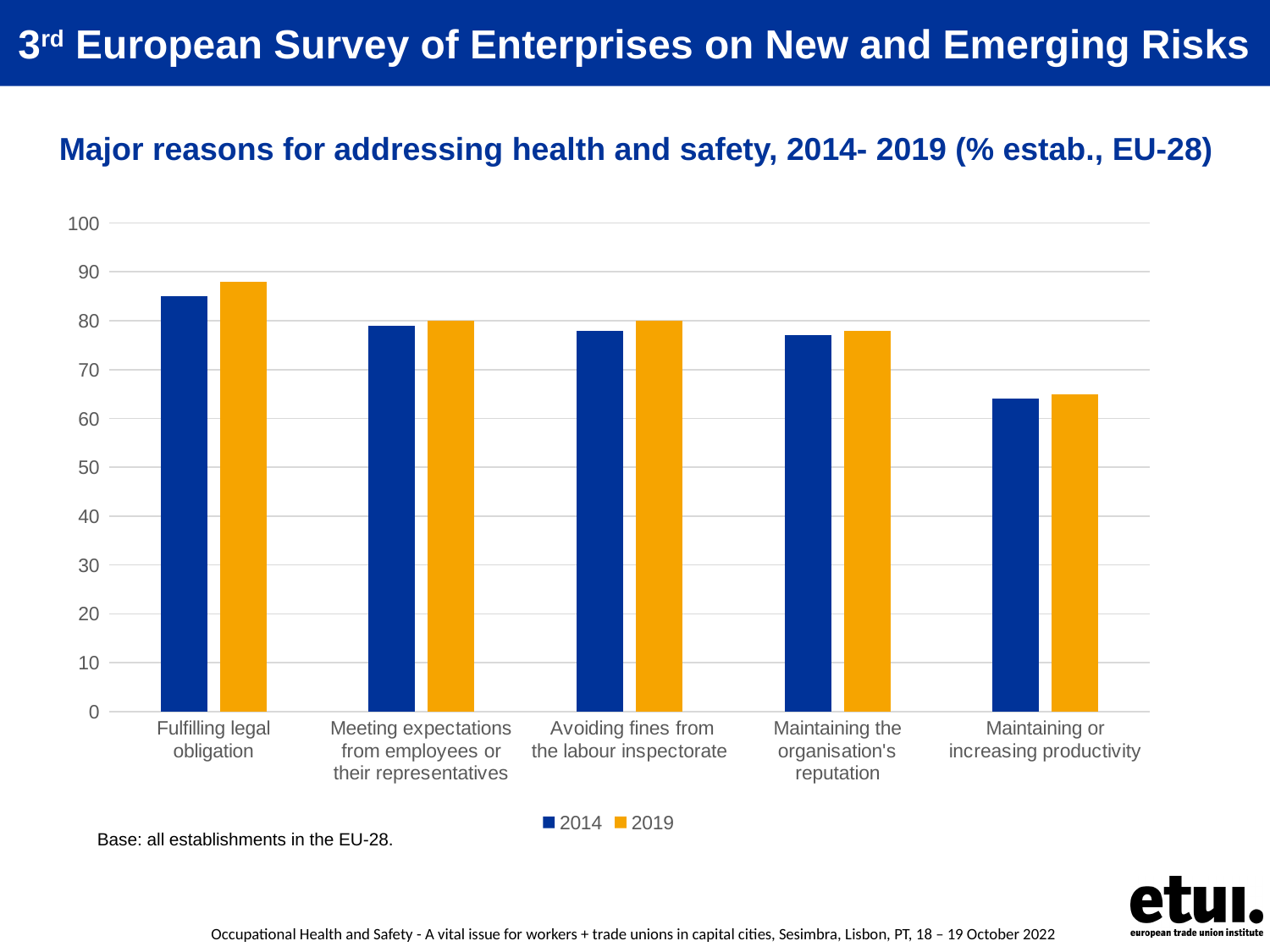
Which category has the highest value for 2019? Fulfilling legal obligation What is the title of the chart? Major reasons for addressing health and safety, 2014- 2019 (% estab., EU-28) Is the 2014 value for Maintaining or increasing productivity greater or less than 70? less Which colour represents the 2019 series in the chart? orange Is the 2019 value for Maintaining or increasing productivity greater or less than 60? greater Is the 2019 value for Fulfilling legal obligation greater or less than 80? greater Which is larger: the 2019 value for Fulfilling legal obligation or the 2019 value for Maintaining or increasing productivity? Fulfilling legal obligation What kind of chart is shown on the slide? bar chart How many categories (reasons) are shown on the x axis of the chart? 5 Which category has the lowest value for 2014? Maintaining or increasing productivity How many series does the legend of the chart list? 2